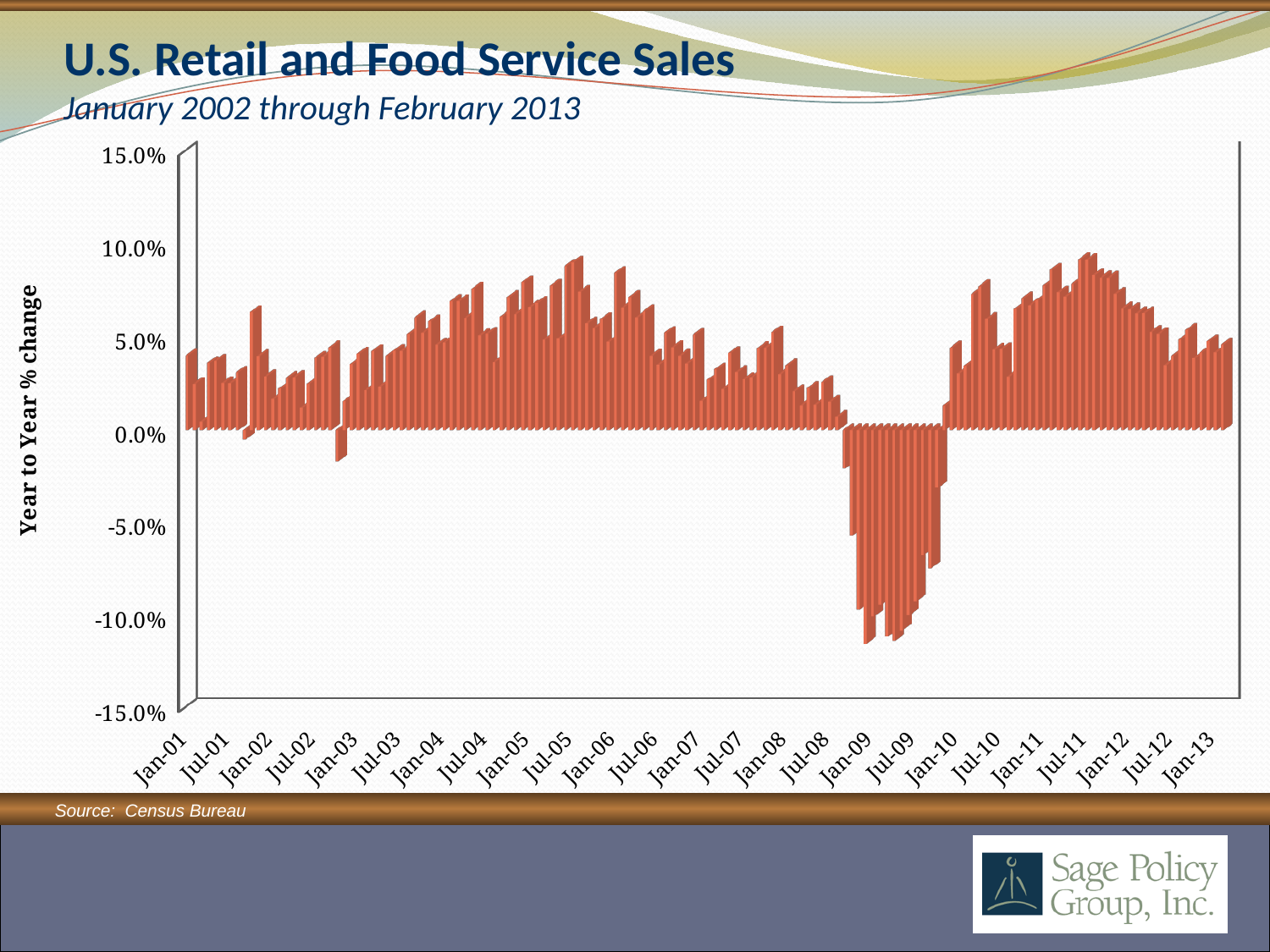
What is the label on the vertical axis of the chart? Year to Year % change Is the value for Jul-05 greater or less than 5.0%? greater Is the value for Jan-11 greater or less than 5.0%? greater What kind of chart is shown on the slide? Bar chart Is the value for Jan-09 greater or less than 0.0%? less What is the title of the chart on the slide? U.S. Retail and Food Service Sales Do the values rise or fall between Jul-09 and Jan-10? rise Do the values rise or fall between Jan-08 and Jan-09? fall Around which x-axis label do the lowest values on the chart occur? Jan-09